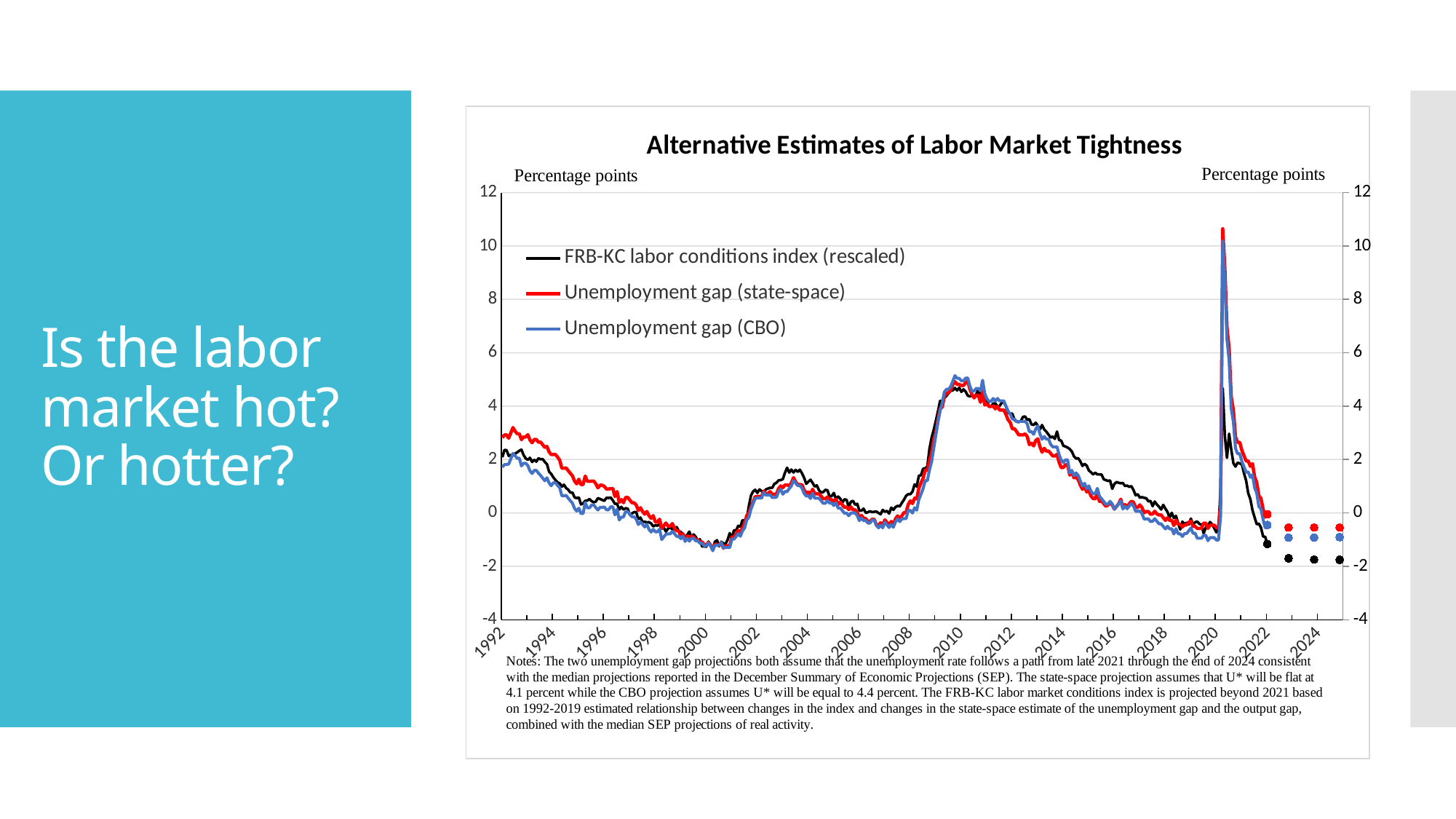
Is the peak value of the Unemployment gap (state-space) series around 2020 greater or less than 10? greater How many series does the legend list? 3 What kind of chart is shown on the slide? line chart Is the projected value of the Unemployment gap (state-space) series in 2024 greater or less than 0? less What is the title of the chart? Alternative Estimates of Labor Market Tightness Is the peak value of the Unemployment gap (CBO) series around 2010 greater or less than 4? greater Which colour is used for the FRB-KC labor conditions index (rescaled) series? black Between 2010 and 2019, do the values of the Unemployment gap (state-space) series generally rise or fall? fall In the 2024 projections, which series is higher: Unemployment gap (state-space) or FRB-KC labor conditions index (rescaled)? Unemployment gap (state-space)